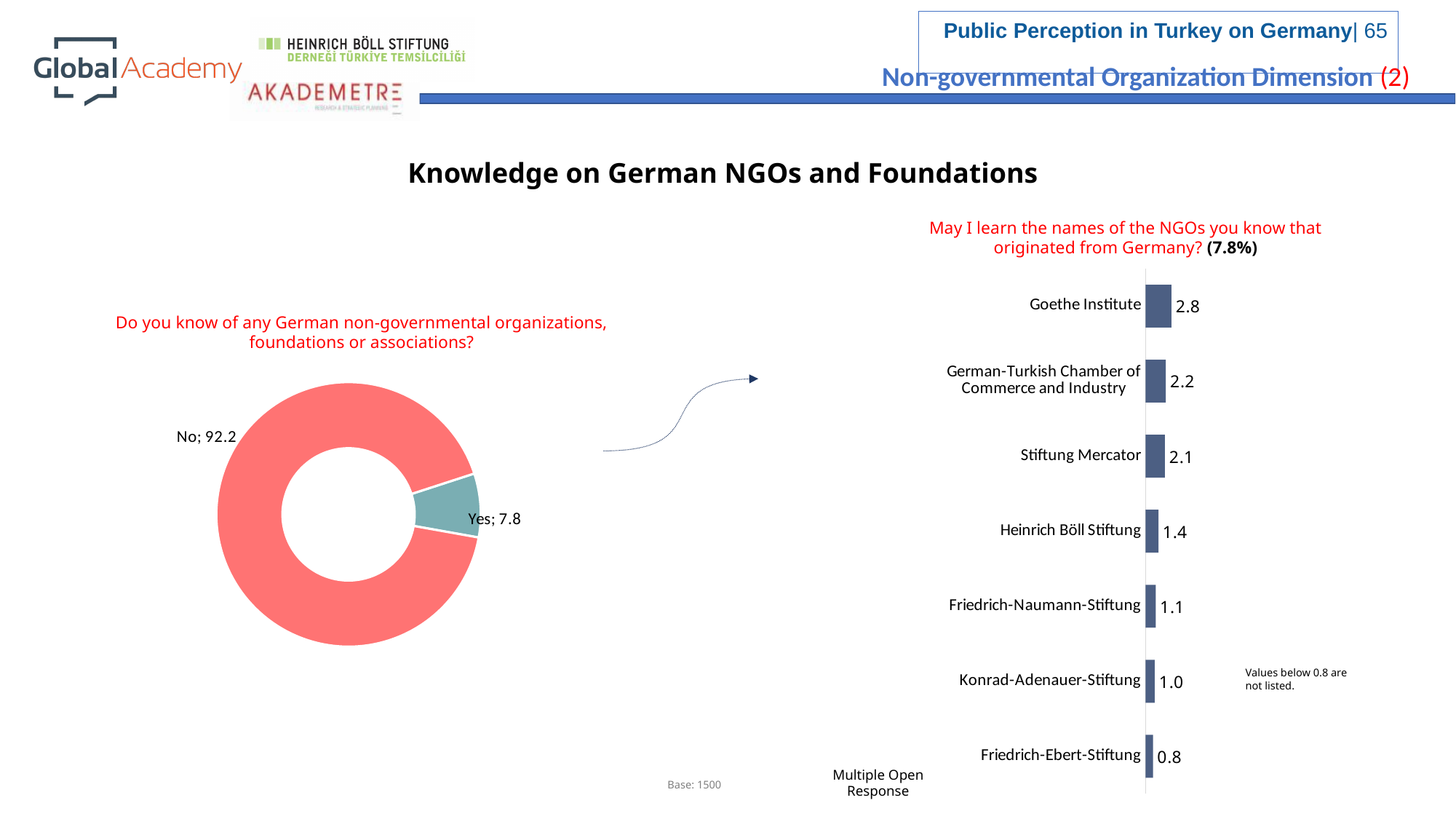
In the bar chart on the right, how many organizations are listed? 7 In the bar chart on the right, what is the difference between the values for Goethe Institute and Stiftung Mercator? 0.7 What kind of chart is the chart on the right? Bar chart In the donut chart on the left, which category is larger, "Yes" or "No"? No In the bar chart on the right, which organization has the lowest value? Friedrich-Ebert-Stiftung In the bar chart on the right, what is the value for Heinrich Böll Stiftung? 1.4 In the donut chart on the left, what is the value for "No"? 92.2 What kind of chart is the chart on the left? Donut (pie) chart In the bar chart on the right, which organization has the highest value? Goethe Institute In the donut chart on the left, what is the difference between the "No" and "Yes" values? 84.4 In the donut chart on the left, what is the value for "Yes"? 7.8 In the bar chart on the right, what is the value for Goethe Institute? 2.8